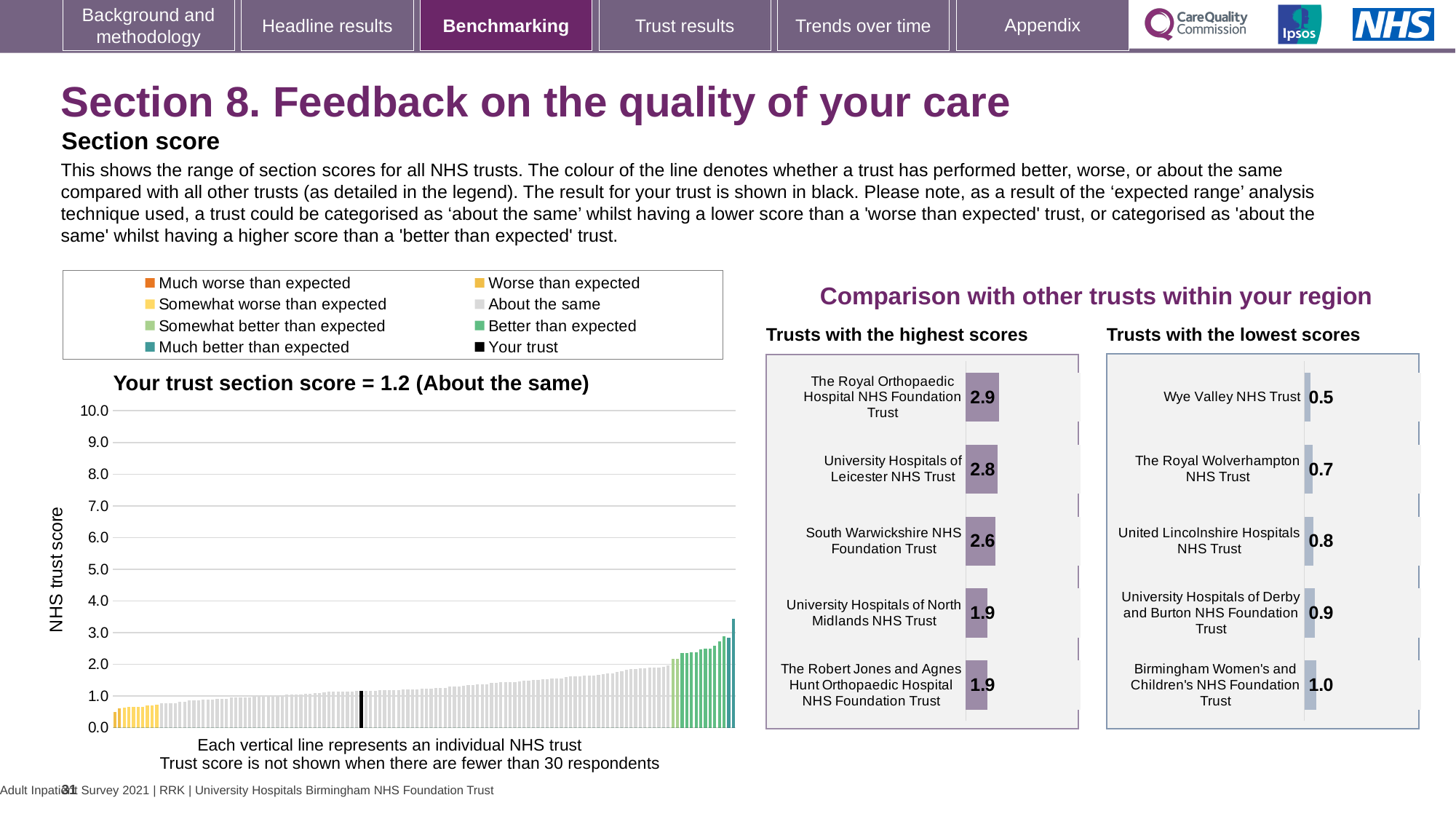
On the 'Your trust section score' chart, what is the section score for your trust? 1.2 On the 'Trusts with the highest scores' chart, which trust has the highest score? The Royal Orthopaedic Hospital NHS Foundation Trust On the 'Your trust section score' chart, is the value of the tallest bar greater or less than 3.0? greater On the 'Your trust section score' chart, do the trust scores rise or fall from left to right? rise What kind of chart is the 'Your trust section score' chart? bar chart On the 'Your trust section score' chart, what category is your trust placed in? About the same On the 'Trusts with the highest scores' chart, what is the difference between the scores of The Royal Orthopaedic Hospital NHS Foundation Trust and University Hospitals of Leicester NHS Trust? 0.1 How many entries does the legend above the 'Your trust section score' chart list? 8 On the 'Trusts with the lowest scores' chart, which trust has the lowest score? Wye Valley NHS Trust On the 'Trusts with the lowest scores' chart, which has the larger score: United Lincolnshire Hospitals NHS Trust or Birmingham Women's and Children's NHS Foundation Trust? Birmingham Women's and Children's NHS Foundation Trust On the 'Trusts with the highest scores' chart, what is the score for South Warwickshire NHS Foundation Trust? 2.6 On the 'Trusts with the lowest scores' chart, how many trusts are shown? 5